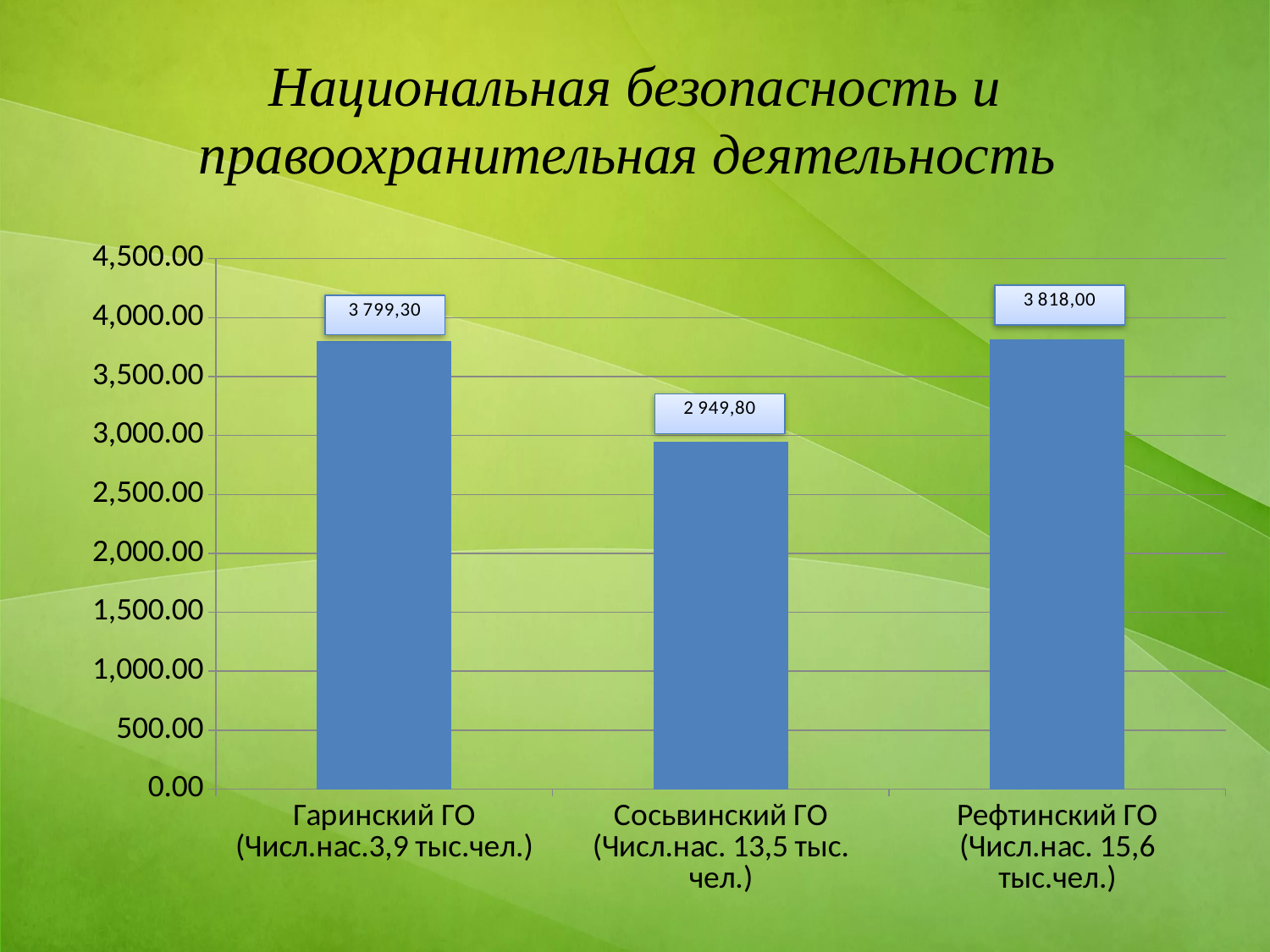
What is the value for Сосьвинский ГО? 2 949,80 Which is larger, the value for Гаринский ГО or the value for Сосьвинский ГО? Гаринский ГО What is the difference between the values for Рефтинский ГО and Сосьвинский ГО? 868,20 Which category has the highest value? Рефтинский ГО Is the value for Сосьвинский ГО greater or less than 3,000.00? less What is the value for Гаринский ГО? 3 799,30 Which category has the lowest value? Сосьвинский ГО How many categories are shown in the chart? 3 What kind of chart is shown on the slide? bar chart What is the title of the slide? Национальная безопасность и правоохранительная деятельность What is the difference between the values for Гаринский ГО and Сосьвинский ГО? 849,50 What is the value for Рефтинский ГО? 3 818,00